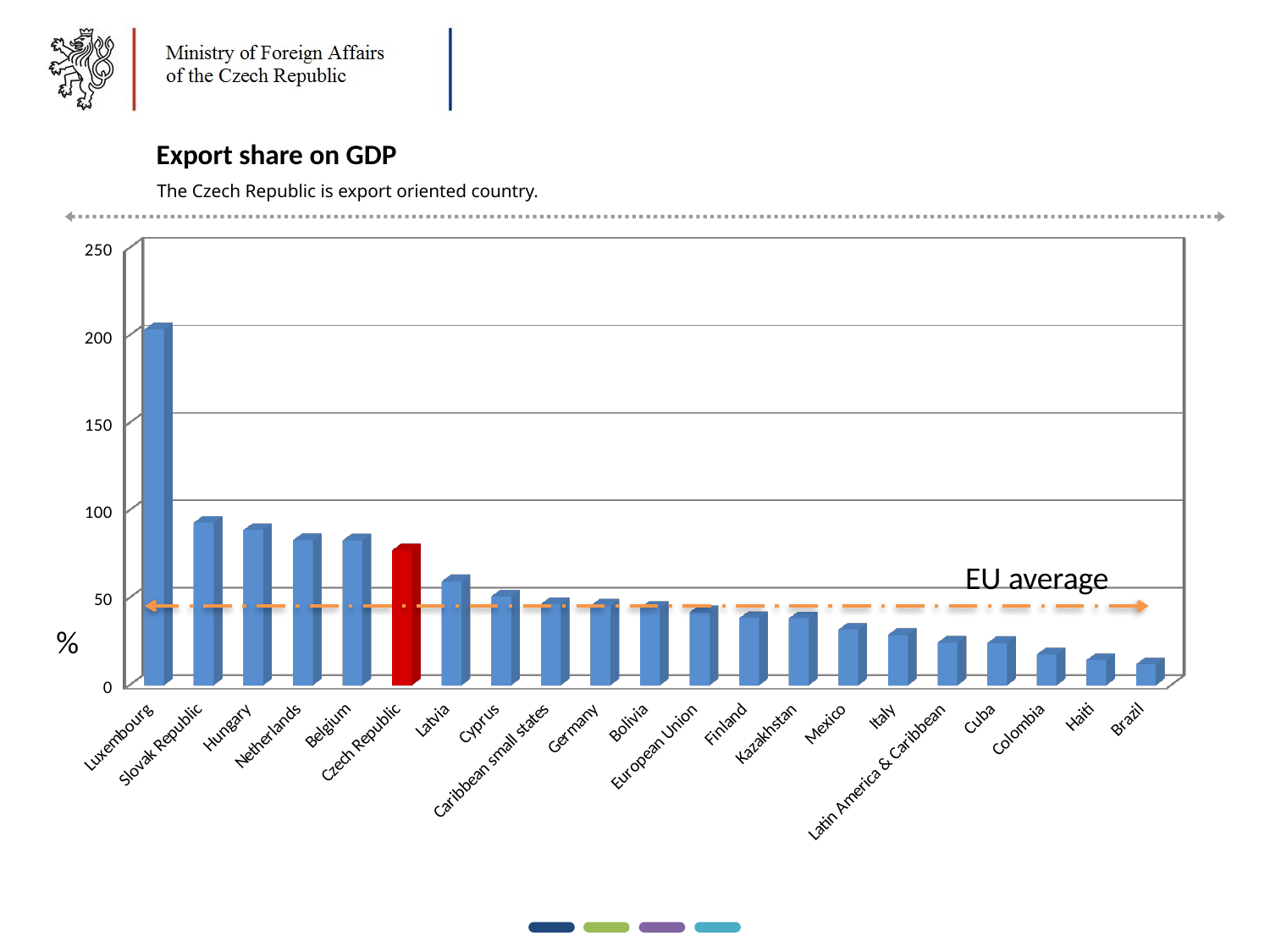
Is the value for the Czech Republic greater or less than 100? less Which country has the highest export share on GDP in the chart? Luxembourg Which category has the lowest export share on GDP in the chart? Brazil Which country's bar is coloured red in the chart? Czech Republic Is the value for the Czech Republic greater or less than 50? greater Is the value for Luxembourg greater or less than 150? greater Do the values rise or fall moving from left to right along the x axis? fall What kind of chart is shown on the slide? bar chart How many categories are plotted in the chart? 21 Which has a higher export share on GDP, the Czech Republic or Germany? Czech Republic What does the orange dashed horizontal line in the chart represent? EU average